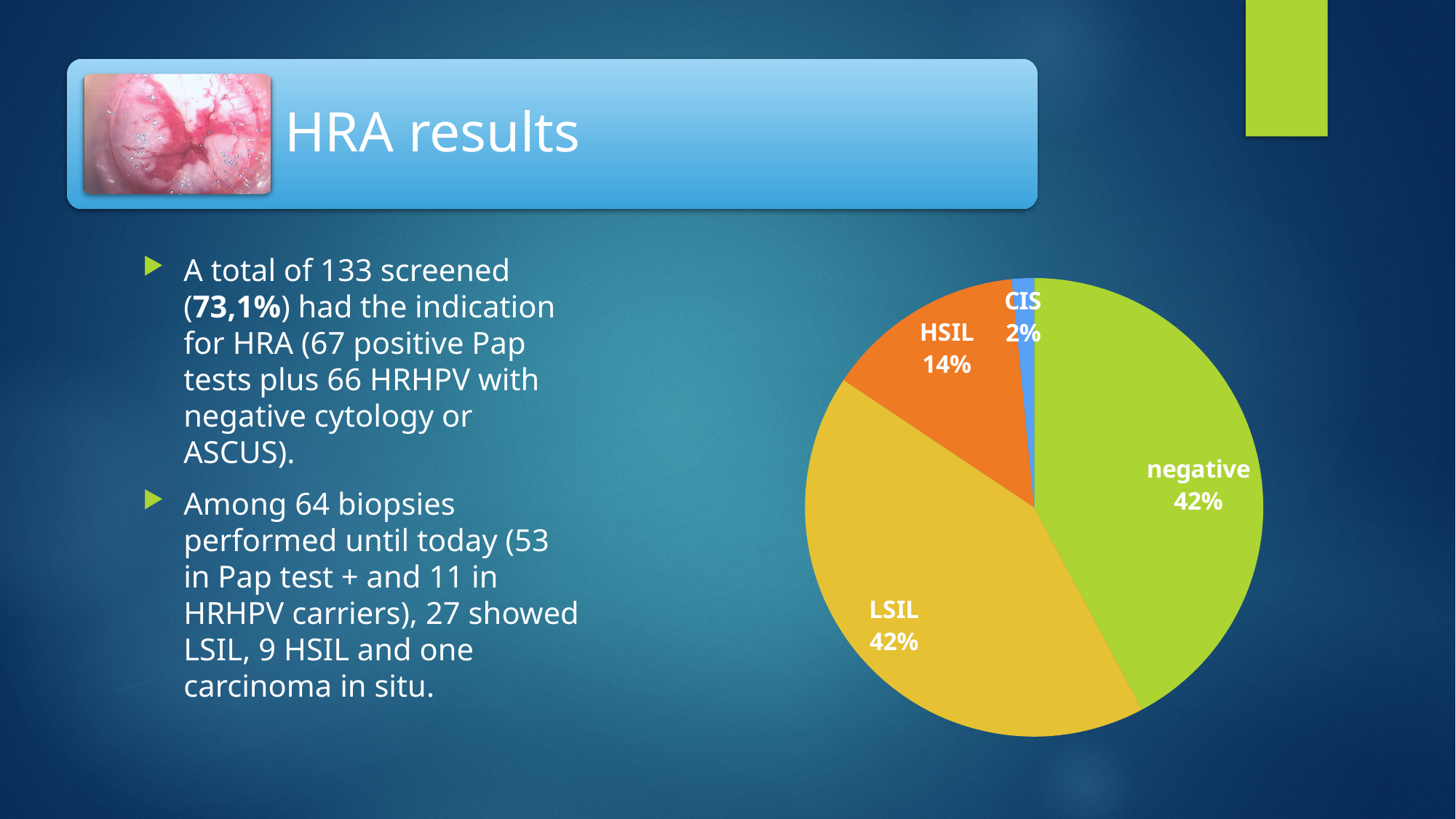
What is the value shown for HSIL in the pie chart? 14% Which slice is larger in the pie chart, LSIL or HSIL? LSIL What colour is the negative slice in the pie chart? Green What percentage of the pie chart is labelled negative? 42% How many categories are shown in the pie chart? 4 What percentage does the LSIL slice show in the pie chart? 42% Which slice is larger in the pie chart, HSIL or CIS? HSIL Which category has the smallest slice in the pie chart? CIS What is the value shown for CIS in the pie chart? 2% What share of the pie does the CIS slice represent? 2% What kind of chart is shown on the slide? Pie chart By how many percentage points does the HSIL slice exceed the CIS slice? 12 percentage points